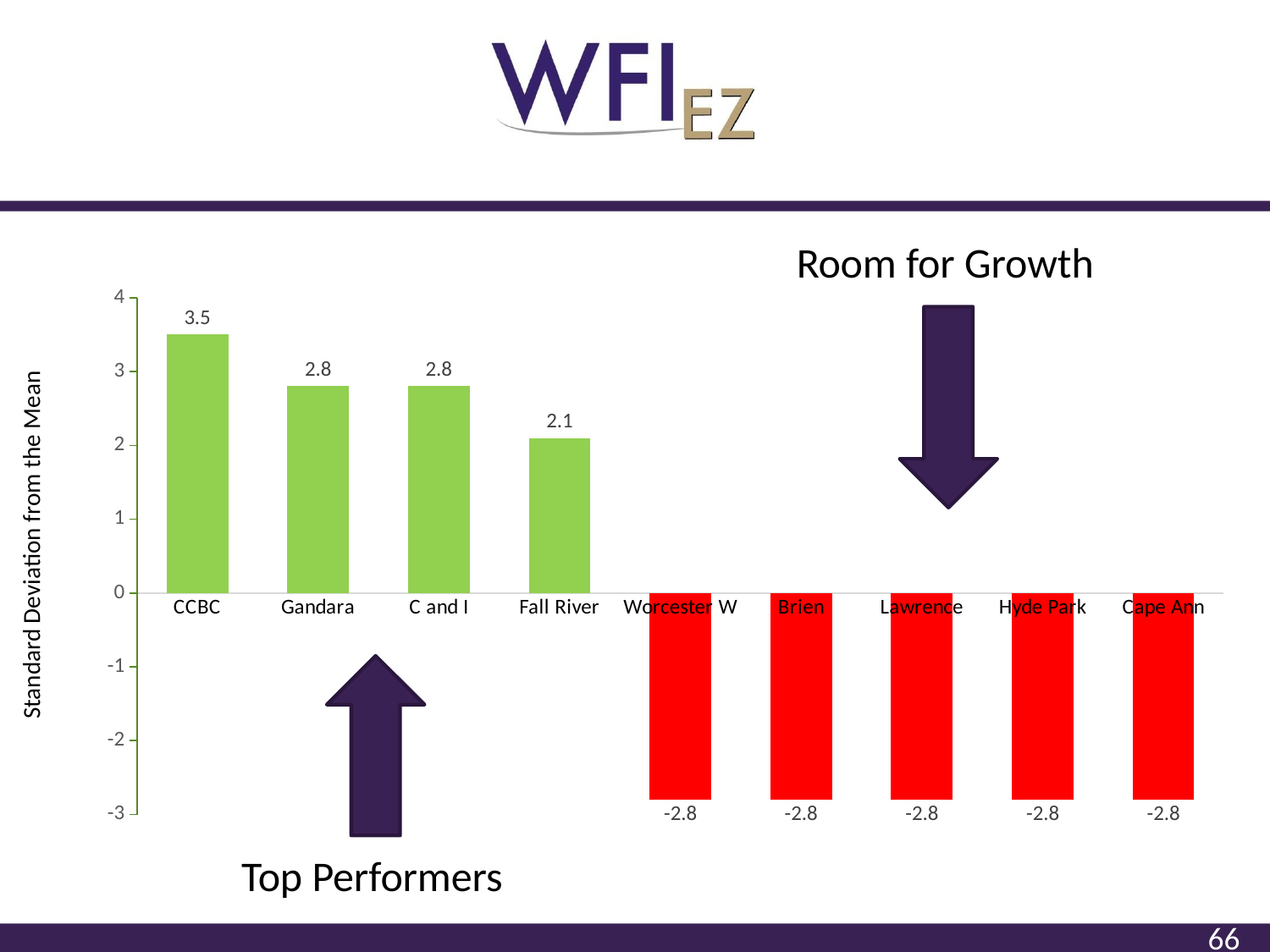
What is the difference between the values for CCBC and Fall River? 1.4 What is the title of the vertical axis? Standard Deviation from the Mean Which category has the highest value? CCBC What is the value for Fall River? 2.1 What is the value for CCBC? 3.5 How many categories are shown on the x axis? 9 Is the value for CCBC greater or less than 3? greater What is the difference between the values for Gandara and Fall River? 0.7 Which is larger, the value for CCBC or the value for Gandara? CCBC What is the value for Lawrence? -2.8 How many bars are coloured red? 5 What kind of chart is shown on the slide? Bar chart